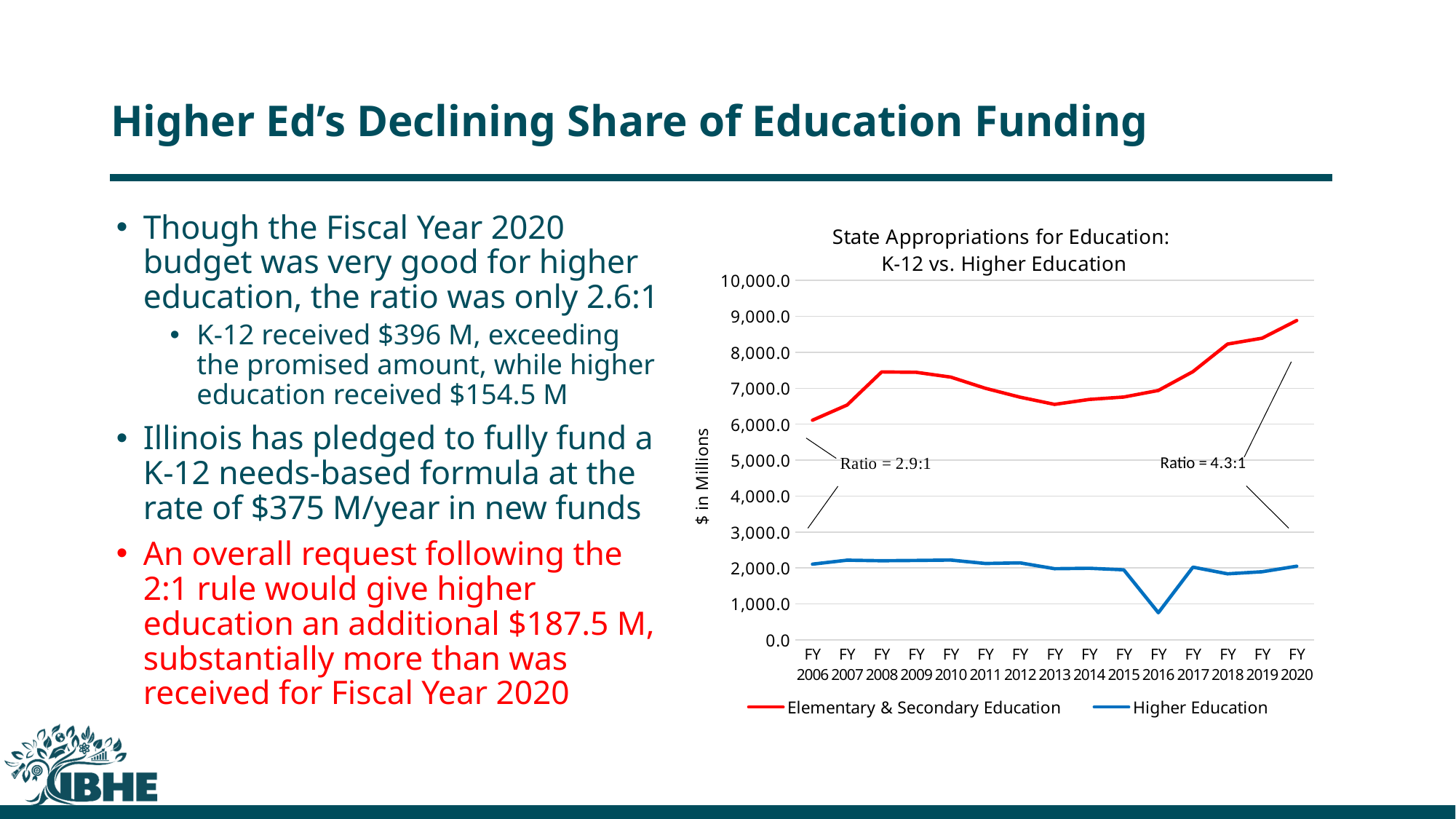
What is the title of the chart? State Appropriations for Education: K-12 vs. Higher Education Is the value for Elementary & Secondary Education in FY 2020 greater or less than 8,000.0? greater What kind of chart is shown on the slide? Line chart Which series has the larger value in FY 2020, Elementary & Secondary Education or Higher Education? Elementary & Secondary Education In which fiscal year is the Elementary & Secondary Education line at its lowest? FY 2006 How many fiscal years are plotted along the x axis of the chart? 15 Does the Elementary & Secondary Education line rise or fall from FY 2015 to FY 2020? Rise How many series does the chart legend list? 2 In which fiscal year is the Elementary & Secondary Education line at its highest? FY 2020 What is the label on the vertical axis of the chart? $ in Millions Is the value for Higher Education in FY 2016 greater or less than 1,000.0? less In which fiscal year is the Higher Education line at its lowest? FY 2016